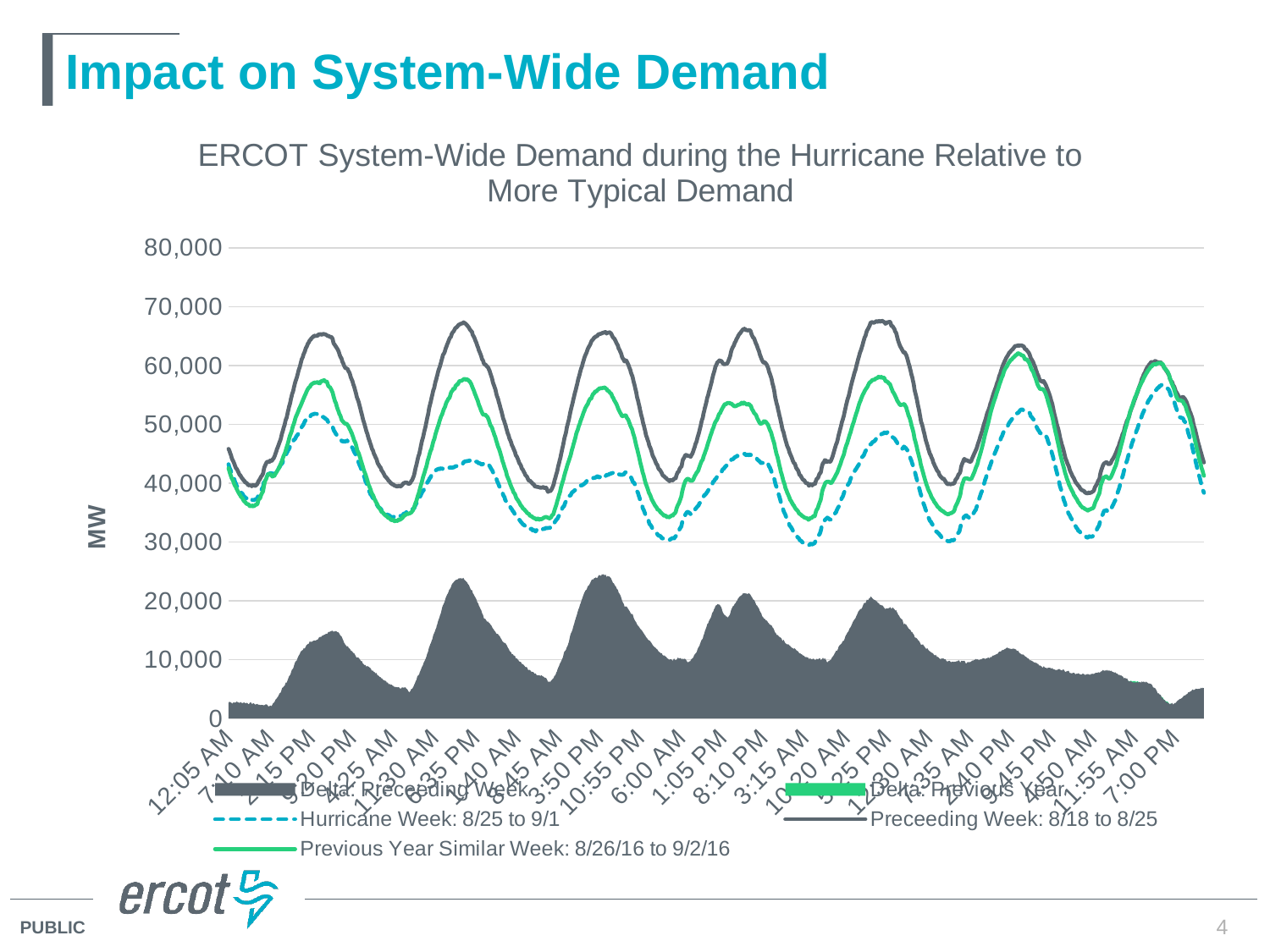
Is the highest value of the Preceeding Week: 8/18 to 8/25 line greater or less than 60,000? greater How many series does the legend list? 5 What kind of chart is shown on the slide? Line chart Is the highest value of the Delta: Preceeding Week series greater or less than 20,000? greater Which line reaches higher peaks, Previous Year Similar Week: 8/26/16 to 9/2/16 or Hurricane Week: 8/25 to 9/1? Previous Year Similar Week: 8/26/16 to 9/2/16 Is the lowest value of the Hurricane Week: 8/25 to 9/1 line greater or less than 40,000? less What is the highest value shown on the vertical axis? 80,000 What is the label on the vertical axis? MW Which line reaches higher peaks, Preceeding Week: 8/18 to 8/25 or Hurricane Week: 8/25 to 9/1? Preceeding Week: 8/18 to 8/25 What is the title of the chart? ERCOT System-Wide Demand during the Hurricane Relative to More Typical Demand